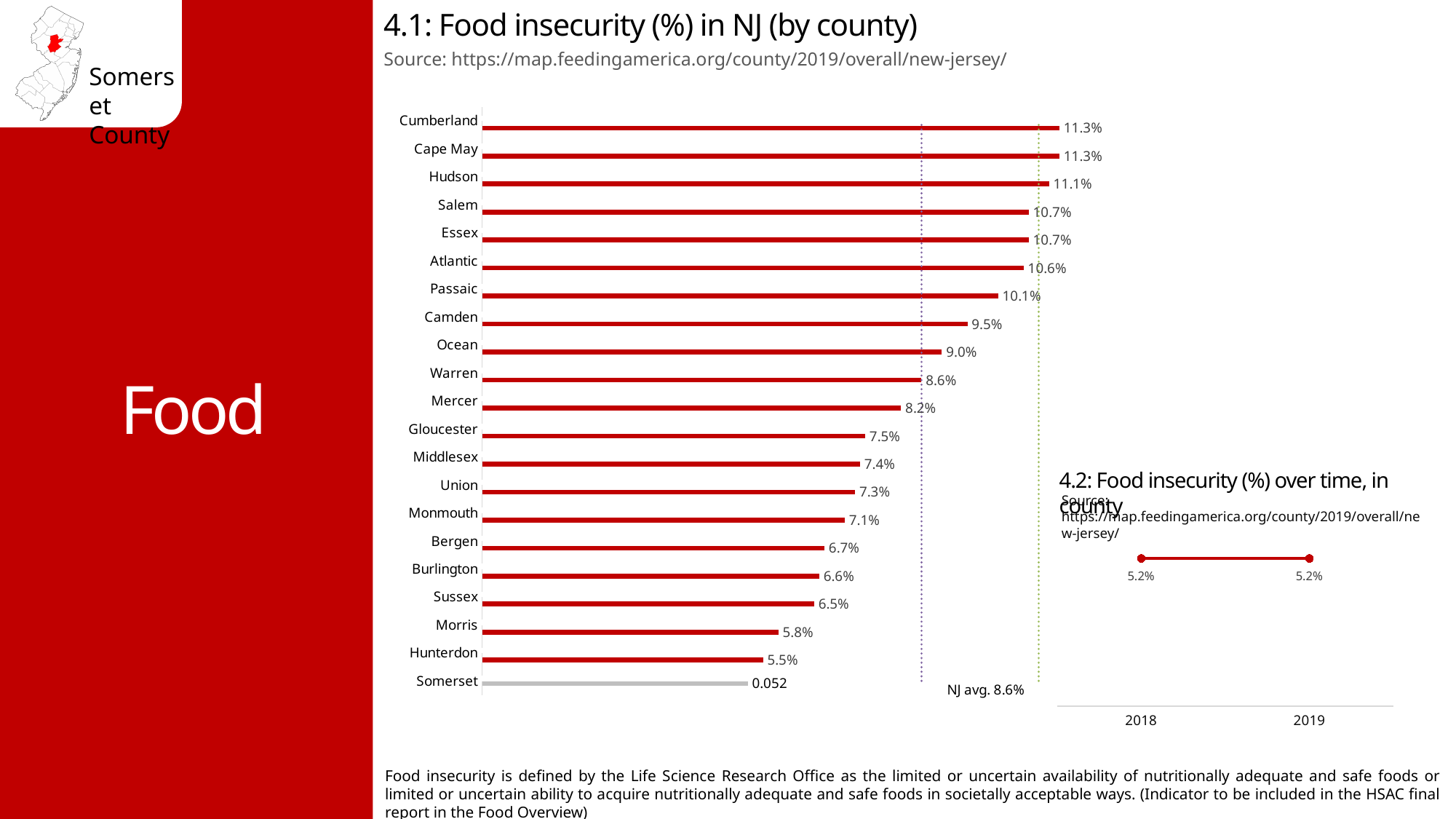
In the chart '4.1: Food insecurity (%) in NJ (by county)', which county has the lowest value? Somerset In the chart '4.1: Food insecurity (%) in NJ (by county)', what is the value for Hunterdon? 5.5% What kind of chart is '4.1: Food insecurity (%) in NJ (by county)'? bar chart In the chart '4.1: Food insecurity (%) in NJ (by county)', how many counties are shown? 21 In the chart '4.2: Food insecurity (%) over time, in county', what is the value for 2019? 5.2% In the chart '4.2: Food insecurity (%) over time, in county', do values rise, fall or stay the same from 2018 to 2019? stay the same In the chart '4.1: Food insecurity (%) in NJ (by county)', what is the value for Mercer? 8.2% In the chart '4.1: Food insecurity (%) in NJ (by county)', what is the value for Hudson? 11.1% In the chart '4.1: Food insecurity (%) in NJ (by county)', which is larger, Bergen or Burlington? Bergen In the chart '4.1: Food insecurity (%) in NJ (by county)', what is the difference between Camden and Ocean? 0.5% In the chart '4.2: Food insecurity (%) over time, in county', how many data points are plotted? 2 In the chart '4.1: Food insecurity (%) in NJ (by county)', what NJ average is marked by the dotted line? 8.6%